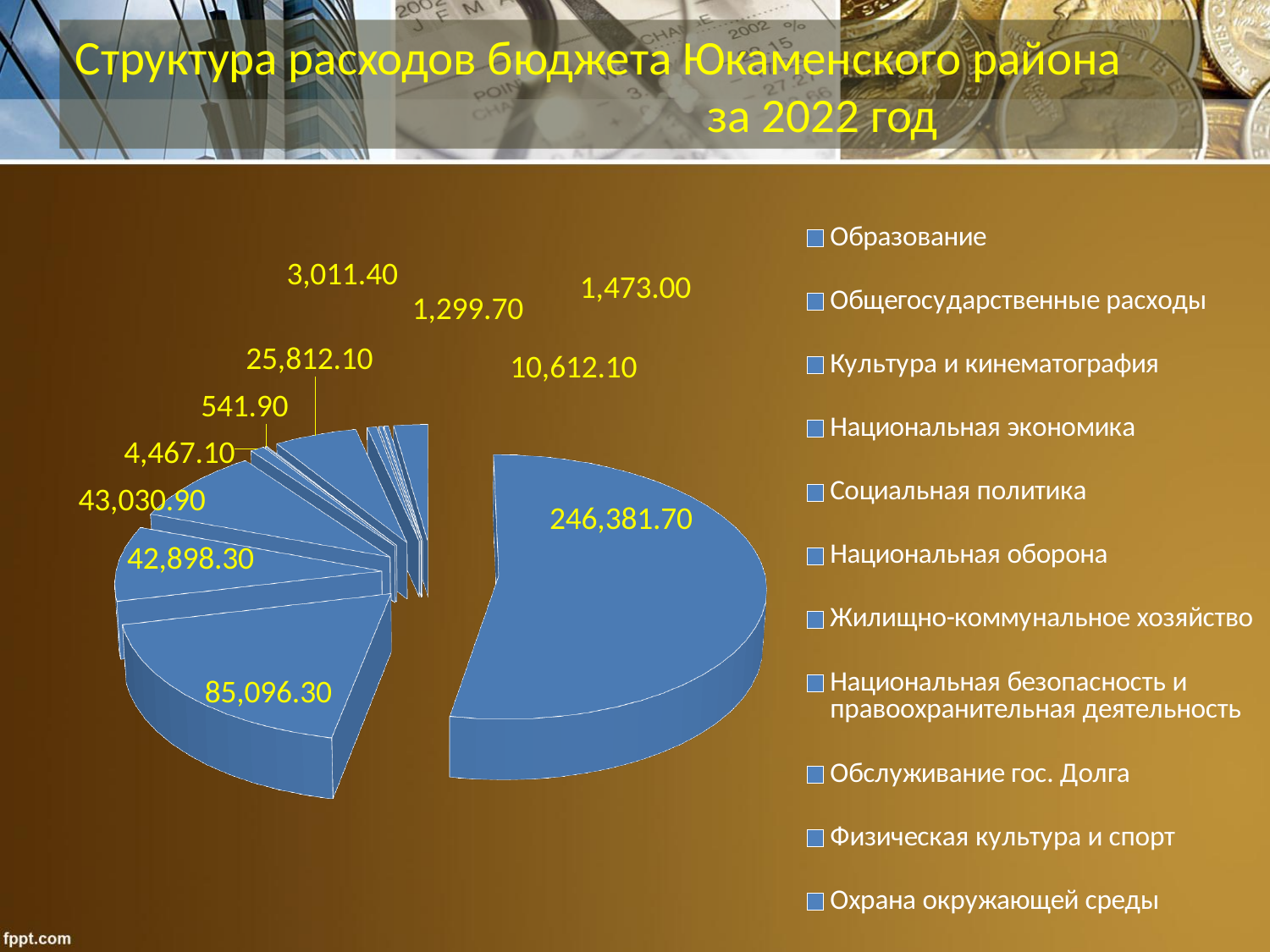
Which labelled value is larger: 1,473.00 or 1,299.70? 1,473.00 What kind of chart is shown on the slide? pie chart What is the largest value labelled on the pie chart? 246,381.70 What is the second largest value labelled on the pie chart? 85,096.30 What is the difference between the slices labelled 25,812.10 and 10,612.10? 15,200.00 What is the smallest value labelled on the pie chart? 541.90 What is the difference between the slices labelled 43,030.90 and 42,898.30? 132.60 What is the title of the slide containing the pie chart? Структура расходов бюджета Юкаменского района за 2022 год What is the first entry listed in the pie chart's legend? Образование What is the difference between the largest labelled slice (246,381.70) and the second largest (85,096.30)? 161,285.40 How many categories does the legend of the pie chart list? 11 Which labelled value is larger: 43,030.90 or 42,898.30? 43,030.90